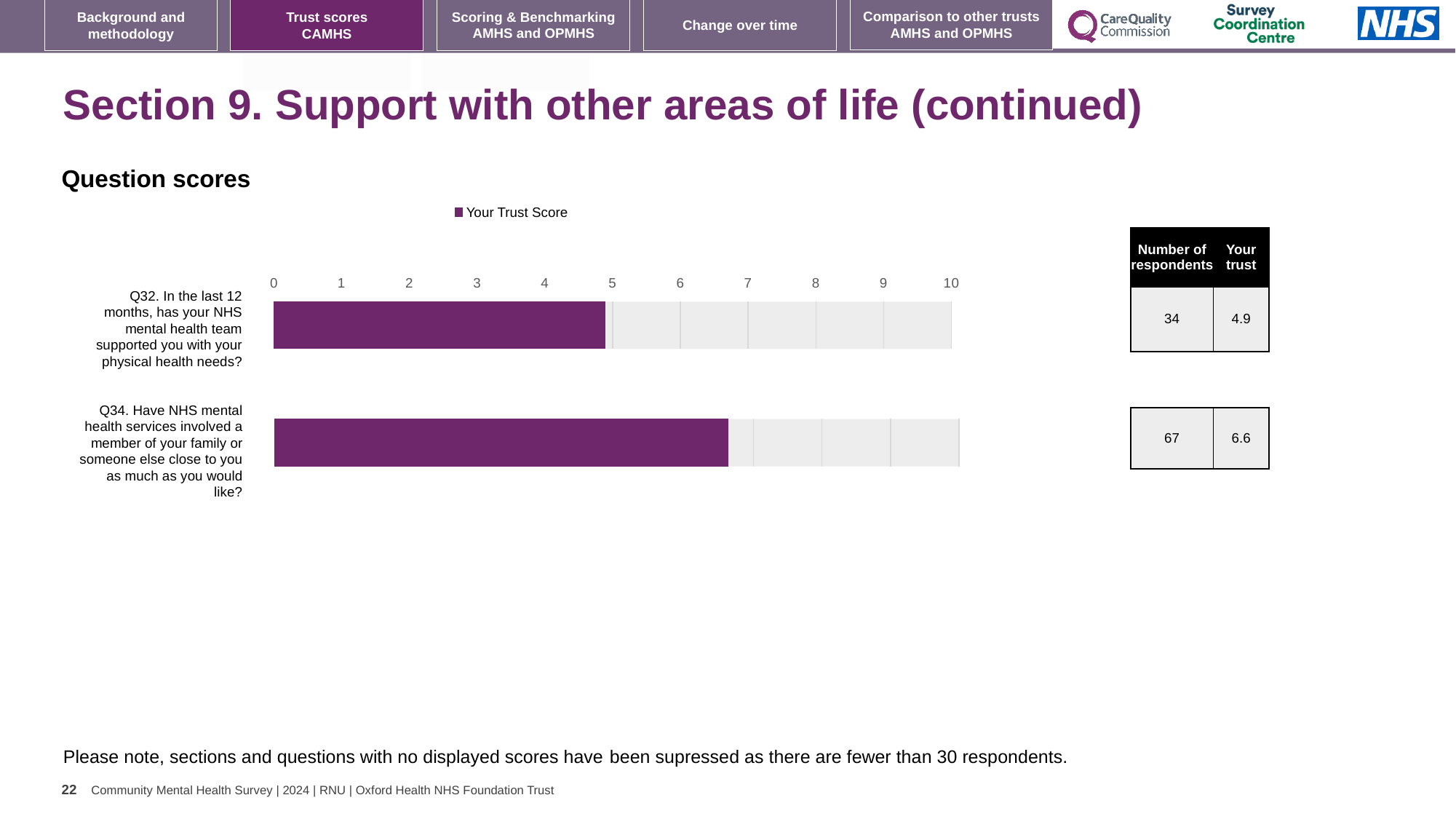
What is the trust score for Q32 (support with physical health needs)? 4.9 Which question has the lowest trust score in the chart? Q32 How many respondents answered Q34 according to the table beside the chart? 67 Is the trust score for Q32 greater or less than 5? less Which question has the higher trust score, Q32 or Q34? Q34 How many series does the chart legend list? 1 What is the series name shown in the chart legend? Your Trust Score Is the trust score for Q34 greater or less than 6? greater How many questions (bars) are plotted in the chart? 2 What kind of chart is shown under "Question scores"? bar chart What is the trust score for Q34 (involving family or someone close as much as you would like)? 6.6 What is the difference between the trust scores for Q34 and Q32? 1.7